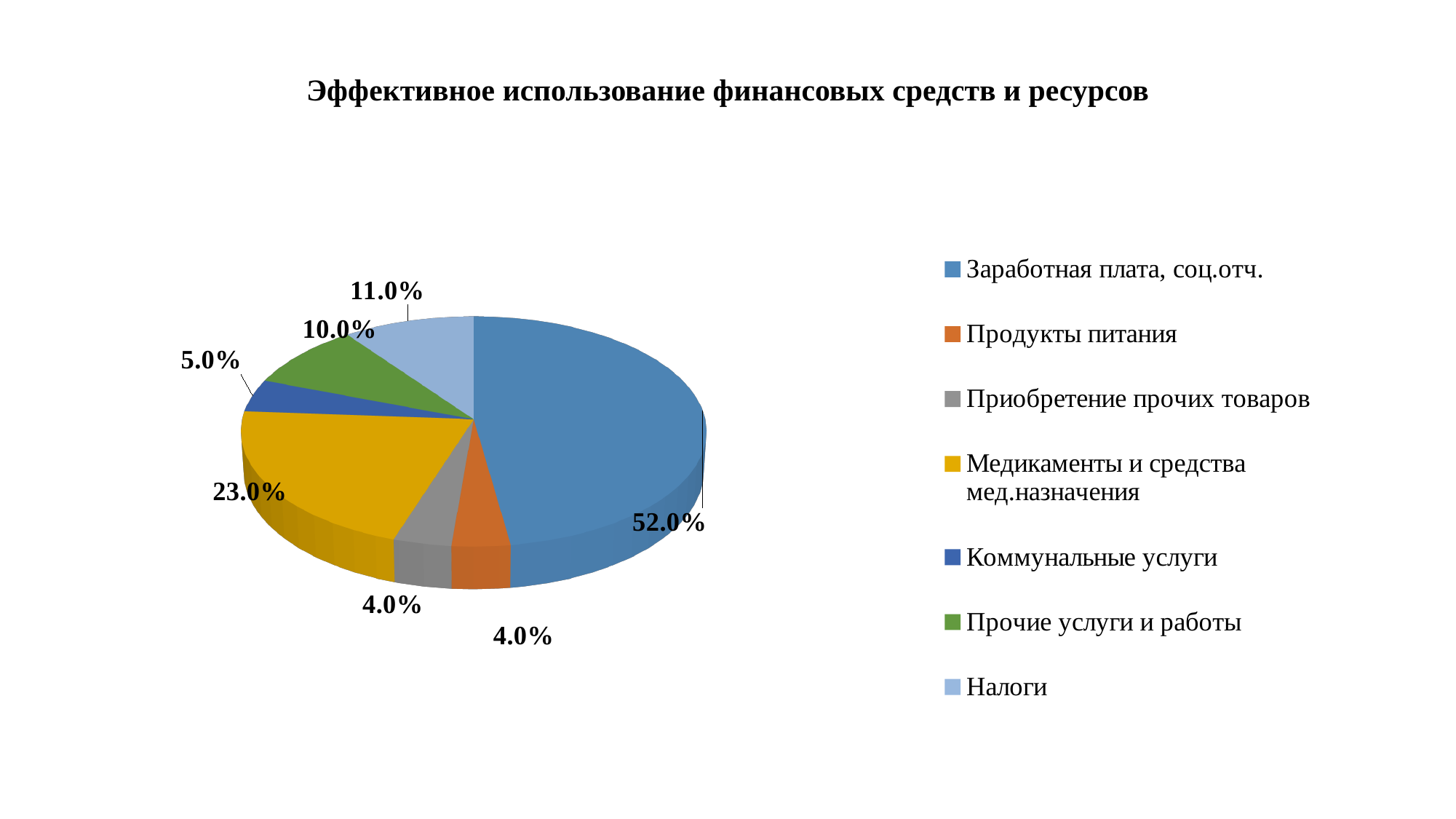
Which colour represents Продукты питания in the legend? orange What kind of chart is shown on the slide? pie chart What is the difference between the share for Заработная плата, соц.отч. and the share for Медикаменты и средства мед.назначения? 29.0% What share of the pie is labelled for Медикаменты и средства мед.назначения? 23.0% What share of the pie is labelled for Налоги? 11.0% What share of the pie is labelled for Прочие услуги и работы? 10.0% Which category has the largest slice of the pie? Заработная плата, соц.отч. How many categories does the legend list? 7 What is the title of the chart? Эффективное использование финансовых средств и ресурсов Which is larger: the slice for Налоги or the slice for Прочие услуги и работы? Налоги